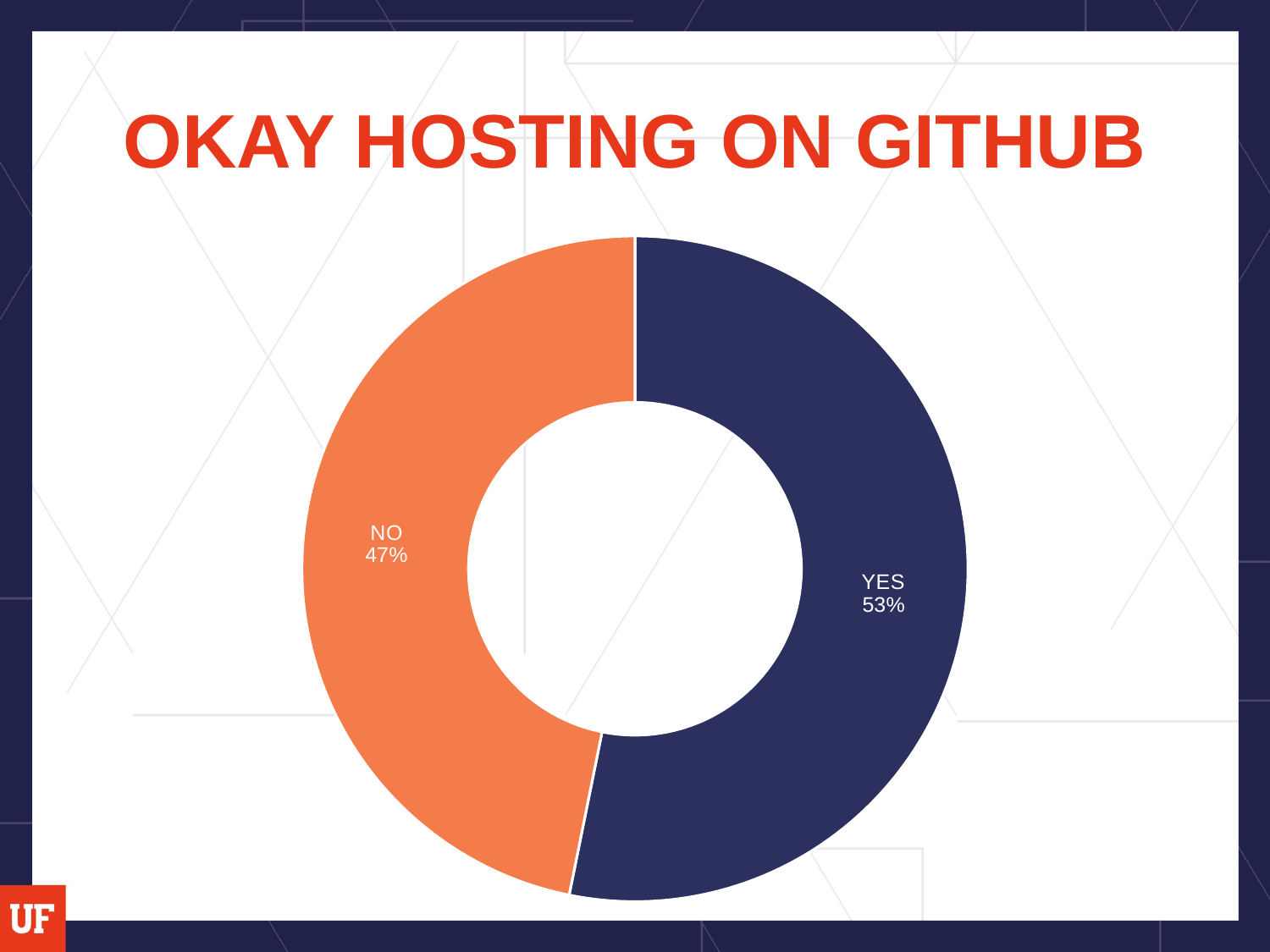
Which category has the largest share of the chart? YES How many categories are shown in the chart? 2 What percentage of respondents answered YES? 53% Which response has the larger share, YES or NO? YES Which category has the smallest share of the chart? NO What percentage of respondents answered NO? 47% What is the title of the slide? OKAY HOSTING ON GITHUB Is the share for YES greater or less than 50%? greater What kind of chart is shown on the slide? Doughnut (pie) chart What colour is the YES segment of the chart? Dark blue What is the difference in percentage points between the YES and NO shares? 6